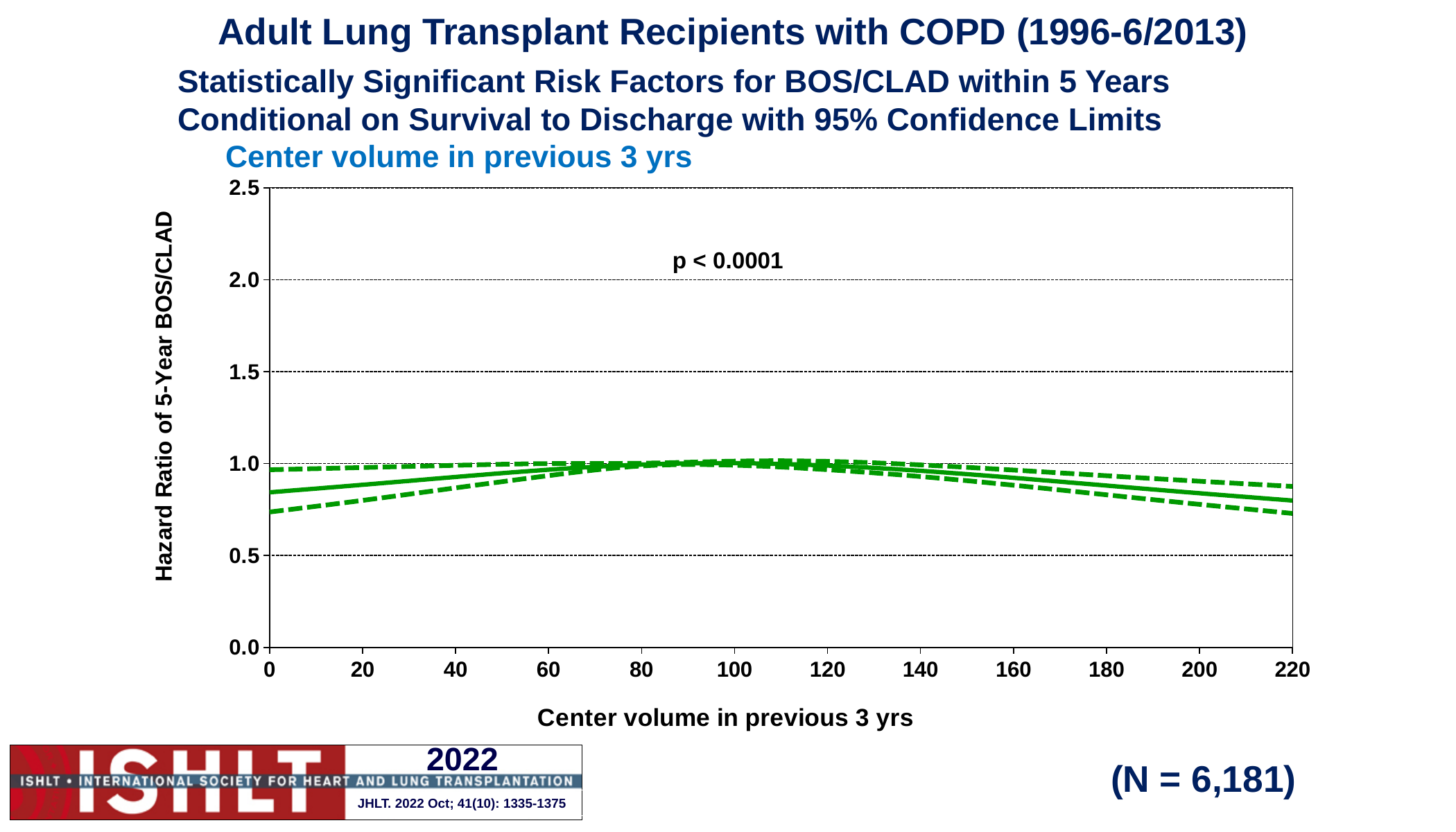
Does the hazard ratio (solid line) rise or fall as center volume increases from 0 to 80? rise Is the hazard ratio (solid line) at a center volume of 0 greater or less than 1.0? less Is the hazard ratio (solid line) at a center volume of 0 greater or less than 0.5? greater What is the maximum value shown on the y axis? 2.5 Does the hazard ratio (solid line) rise or fall as center volume increases from 140 to 220? fall Is the hazard ratio (solid line) at a center volume of 220 greater or less than 1.0? less What is the label of the x axis? Center volume in previous 3 yrs What is the maximum center volume shown on the x axis? 220 What kind of chart is shown on the slide? line chart